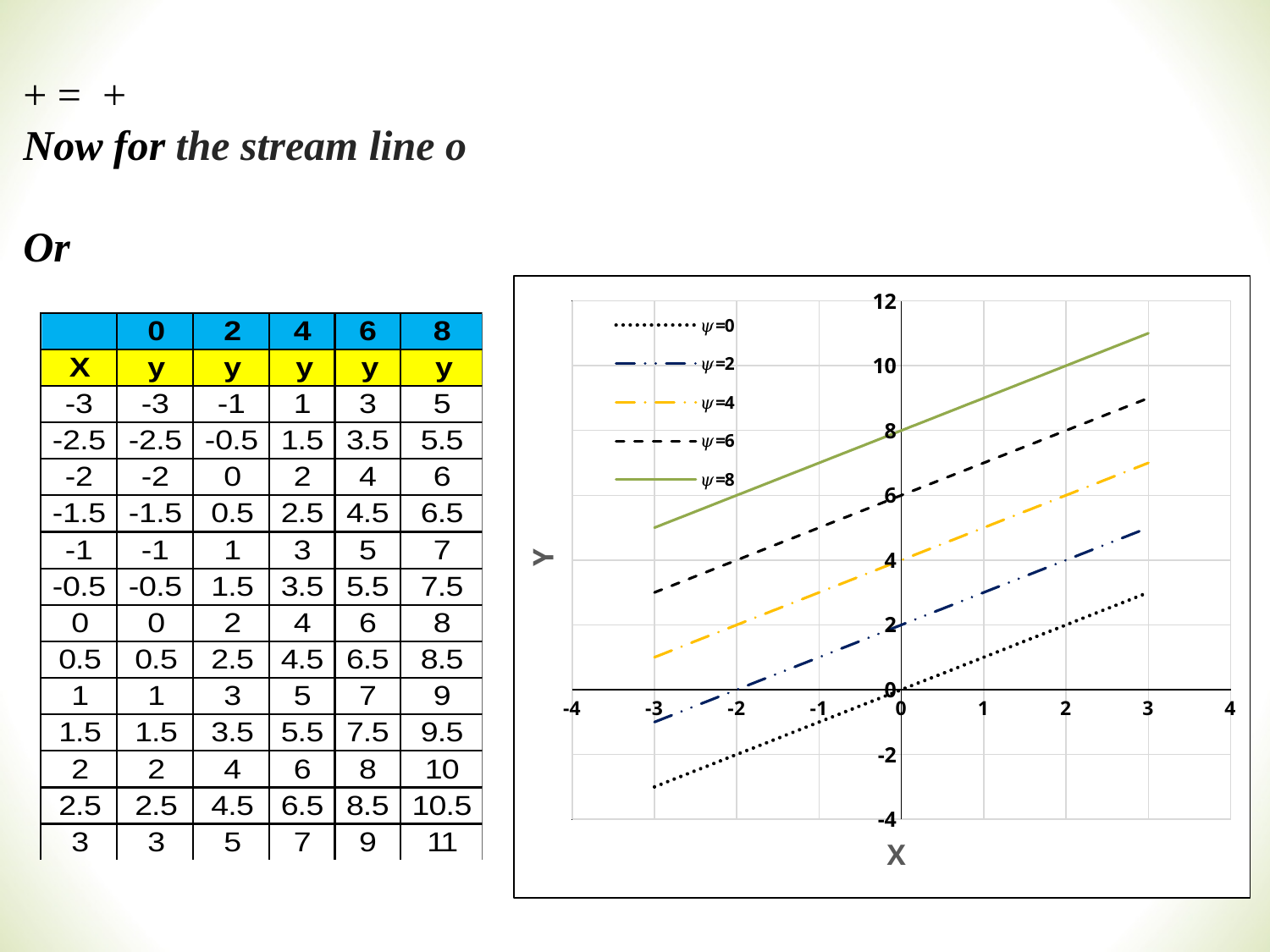
At X = 1, which line has the larger Y value, ψ=6 or ψ=2? ψ=6 What kind of chart is shown on the slide? line chart Do the lines rise or fall as X increases? rise Which series has the highest Y value at X = 0? ψ=8 What is the Y value of the ψ=0 line at X = 0? 0 How many series does the chart's legend list? 5 At X = 0, what is the difference between the Y values of the ψ=8 line and the ψ=0 line? 8 What is the Y value of the ψ=8 line at X = 0? 8 Which series has the lowest Y value at X = 0? ψ=0 What is the Y value of the ψ=8 line at X = 2? 10 Is the Y value of the ψ=0 line at X = -3 greater or less than -2? less Is the Y value of the ψ=8 line at X = 3 greater or less than 10? greater